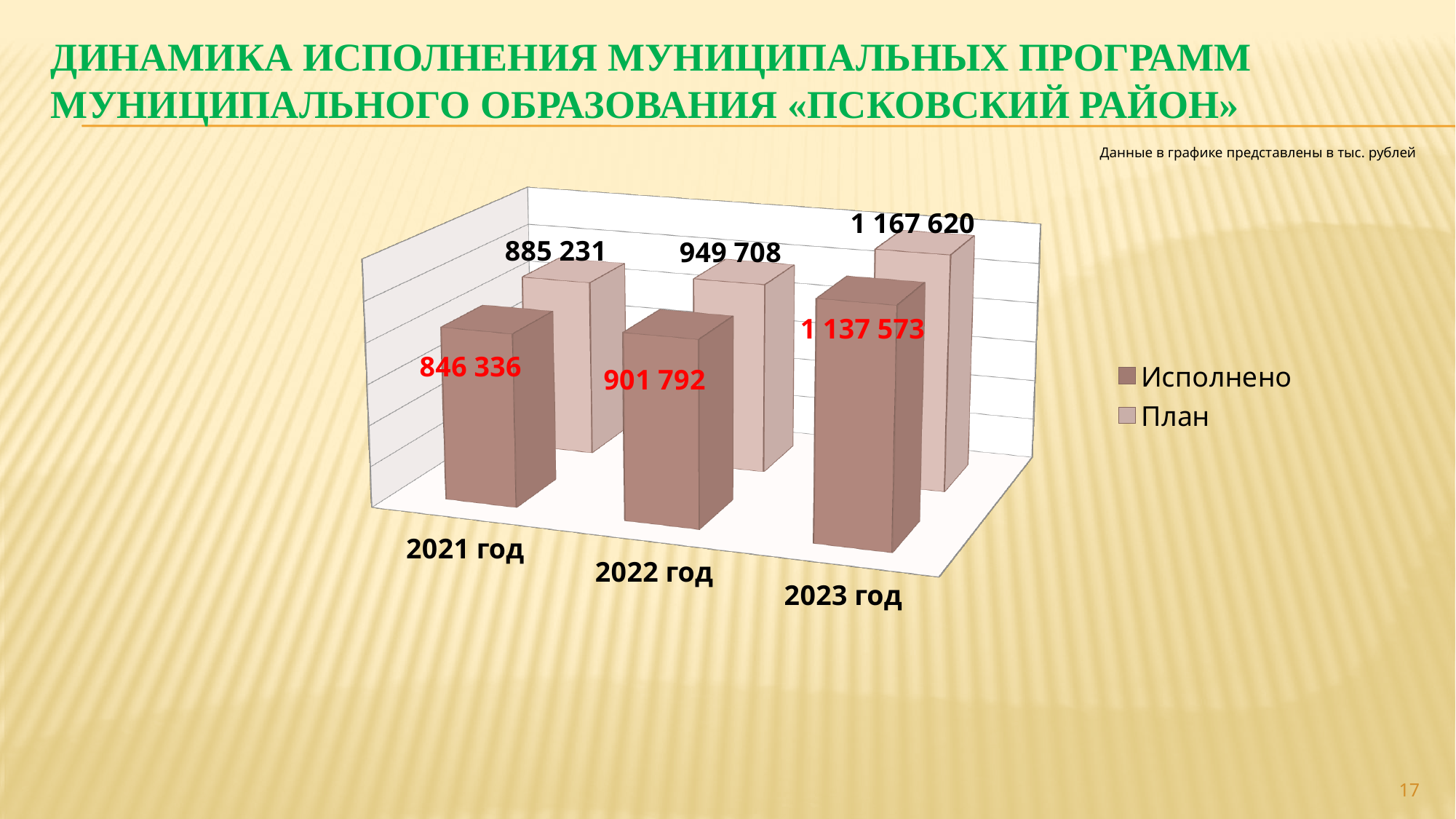
Which year has the highest Исполнено value? 2023 год How many series does the legend list? 2 How many years are shown on the x axis? 3 What is the value of Исполнено for 2023 год? 1 137 573 What is the value of План for 2022 год? 949 708 What is the value of Исполнено for 2021 год? 846 336 What is the difference between План and Исполнено for 2022 год? 47 916 Do the Исполнено values rise or fall from 2021 год to 2023 год? rise What is the value of План for 2023 год? 1 167 620 What is the difference between План and Исполнено for 2021 год? 38 895 Which year has the lowest План value? 2021 год Which is larger for 2023 год: План or Исполнено? План